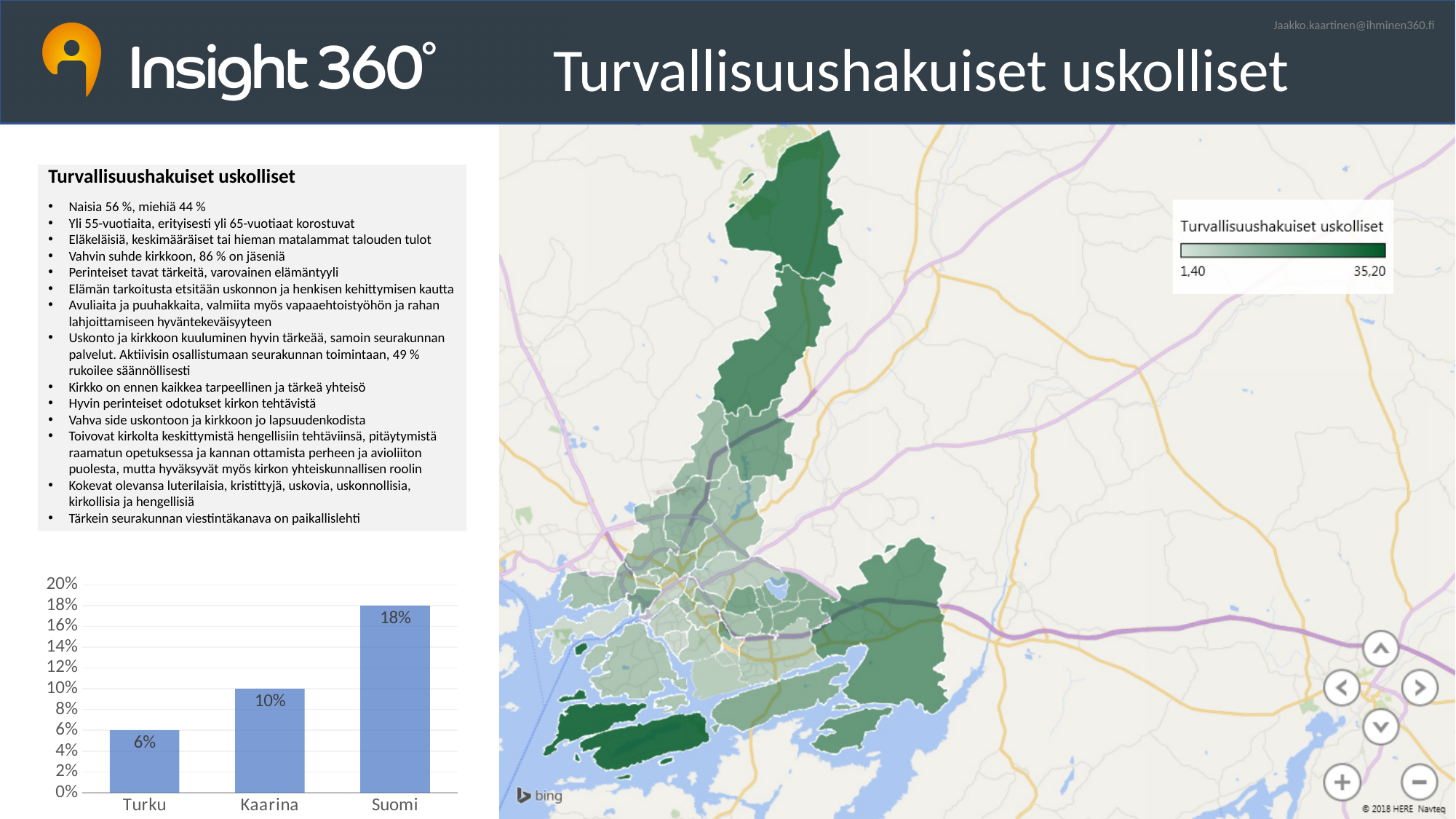
In the bar chart, what is the difference between the values for Suomi and Turku? 12% In the bar chart, do the values rise or fall from Turku to Suomi? Rise In the bar chart, what is the difference between the values for Kaarina and Turku? 4% In the bar chart, which is larger, the value for Kaarina or the value for Turku? Kaarina In the bar chart, what is the value for Turku? 6% In the bar chart, which category has the highest value? Suomi What kind of chart is shown at the bottom left of the slide? Bar chart In the bar chart, what is the value for Kaarina? 10% In the bar chart, which category has the lowest value? Turku How many categories are shown in the bar chart? 3 On the map chart, what are the minimum and maximum values shown on the colour legend? 1,40 and 35,20 In the bar chart, what is the value for Suomi? 18%